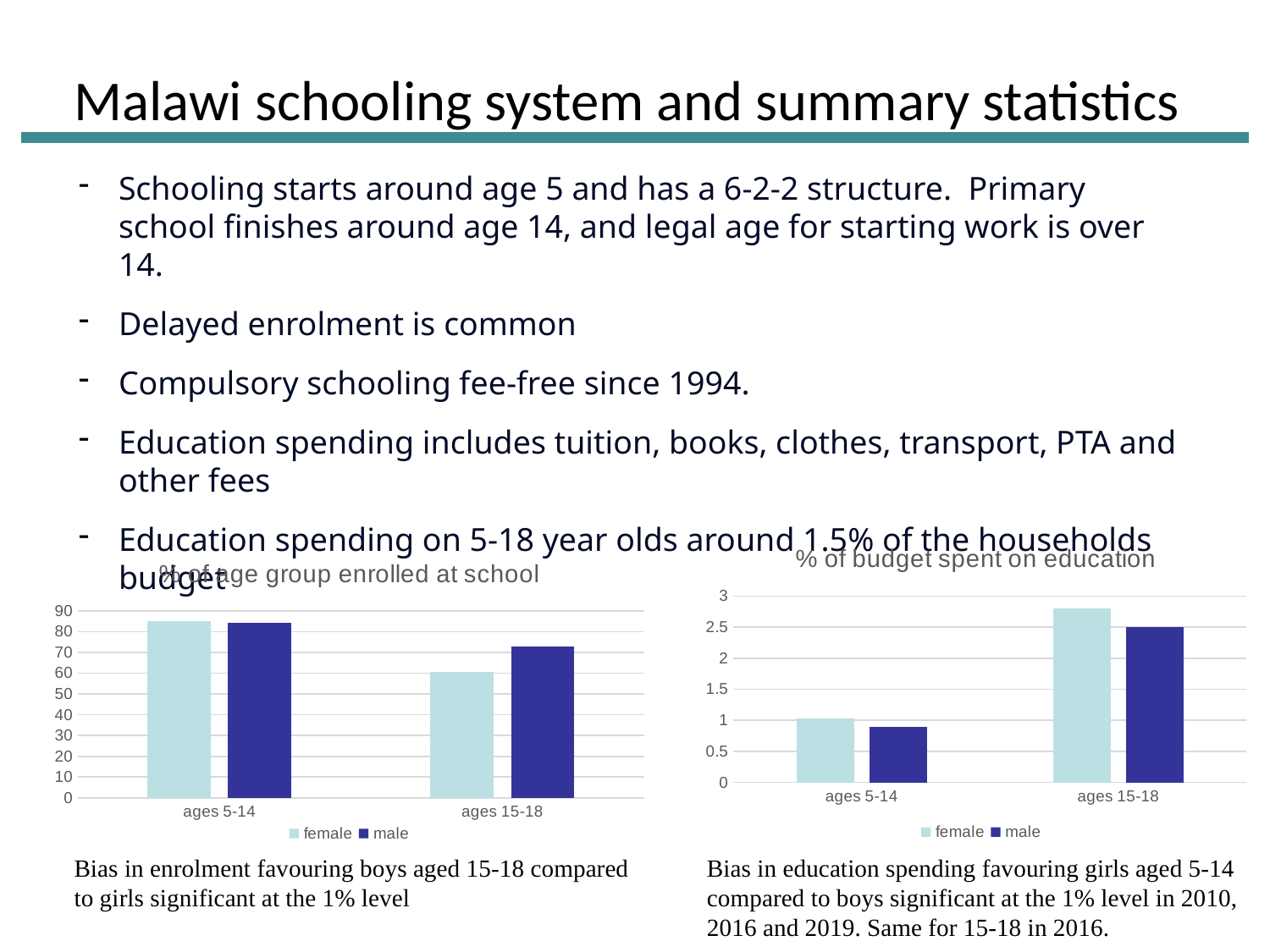
In the chart titled '% of age group enrolled at school', what kind of chart is shown? bar chart In the chart titled '% of age group enrolled at school', is the value for female ages 15-18 greater or less than 70? less In the chart titled '% of budget spent on education', for ages 15-18, which is larger, the female or the male value? female In the chart titled '% of age group enrolled at school', for ages 15-18, which is larger, the female or the male value? male In the chart titled '% of budget spent on education', which bar is the highest? female, ages 15-18 In the chart titled '% of age group enrolled at school', is the value for male ages 15-18 greater or less than 70? greater In the chart titled '% of budget spent on education', is the value for male ages 5-14 greater or less than 1? less In the chart titled '% of age group enrolled at school', which bar is the lowest? female, ages 15-18 In the chart titled '% of budget spent on education', which colour represents the male series? dark blue In the chart titled '% of age group enrolled at school', how many age-group categories are shown on the x axis? 2 In the chart titled '% of age group enrolled at school', how many series does the legend list? 2